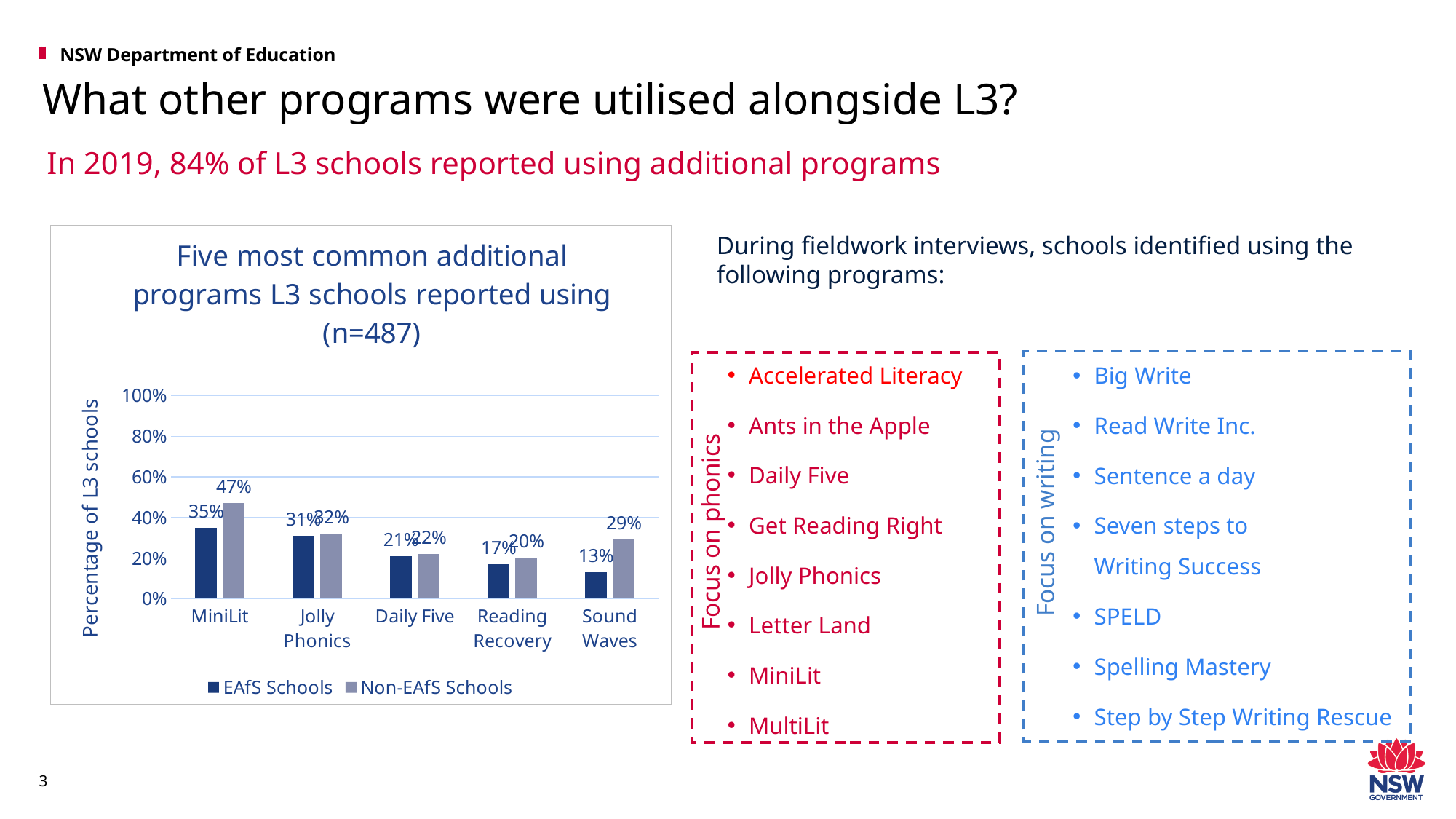
Which is larger for Reading Recovery: EAfS Schools or Non-EAfS Schools? Non-EAfS Schools What is the difference between Non-EAfS Schools and EAfS Schools for MiniLit? 12% How many series does the chart legend list? 2 How many programs are shown on the x axis of the chart? 5 What percentage of Non-EAfS Schools reported using Sound Waves? 29% Which program has the highest value for Non-EAfS Schools? MiniLit Which program has the lowest value for EAfS Schools? Sound Waves What is the difference between Non-EAfS Schools and EAfS Schools for Sound Waves? 16% What kind of chart is shown on the slide? Bar chart What percentage of EAfS Schools reported using MiniLit? 35% What is the sample size (n) given in the chart title? 487 What percentage of EAfS Schools reported using Sound Waves? 13%